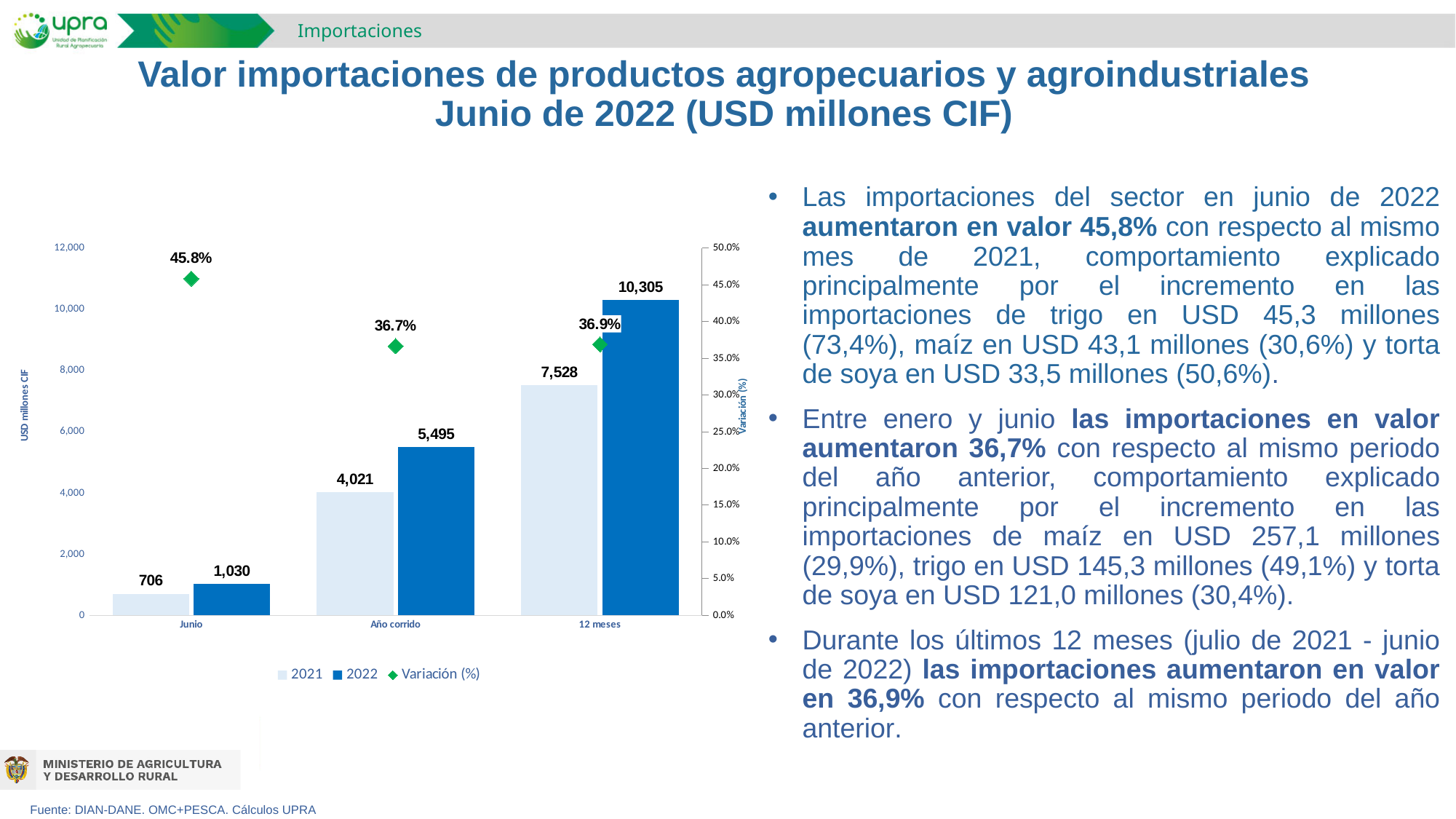
Which is larger for Año corrido, the 2021 value or the 2022 value? 2022 How many categories are shown on the x axis? 3 Do the 2022 values rise or fall from Junio to 12 meses? rise What is the Variación (%) value for 12 meses? 36.9% What is the label of the left vertical axis? USD millones CIF What is the 2022 value for Junio? 1,030 What kind of chart is used for the 2021 and 2022 series? bar chart What is the difference between the 2022 and 2021 values for 12 meses? 2,777 Which category has the lowest Variación (%) value? Año corrido How many series does the legend list? 3 What is the 2021 value for Año corrido? 4,021 Which category has the highest 2022 value? 12 meses